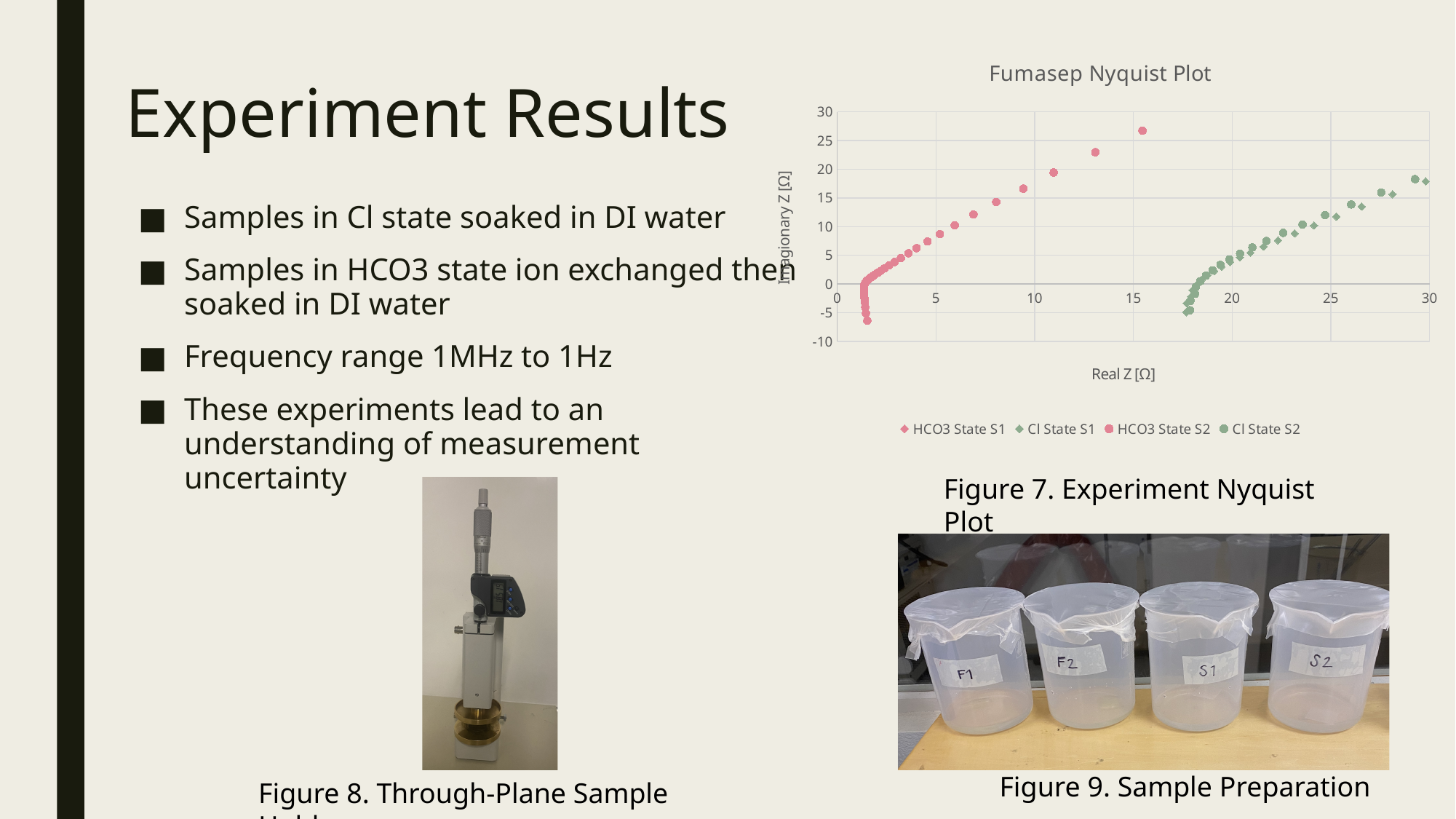
In the Fumasep Nyquist Plot, do the Imaginary Z values of the HCO3 State series rise or fall as Real Z increases? rise What is the title of the chart on the slide? Fumasep Nyquist Plot In the Fumasep Nyquist Plot, is the smallest Real Z value of the Cl State series greater or less than 15? greater What kind of chart is the Fumasep Nyquist Plot? scatter chart How many series does the legend of the Fumasep Nyquist Plot list? 4 In the Fumasep Nyquist Plot, which series has the larger Real Z values, the Cl State series or the HCO3 State series? Cl State In the Fumasep Nyquist Plot, is the lowest Imaginary Z value of the HCO3 State series greater or less than 0? less In the Fumasep Nyquist Plot, is the highest Imaginary Z value reached by the HCO3 State series greater or less than 25? greater What is the x-axis label of the Fumasep Nyquist Plot? Real Z [Ω]